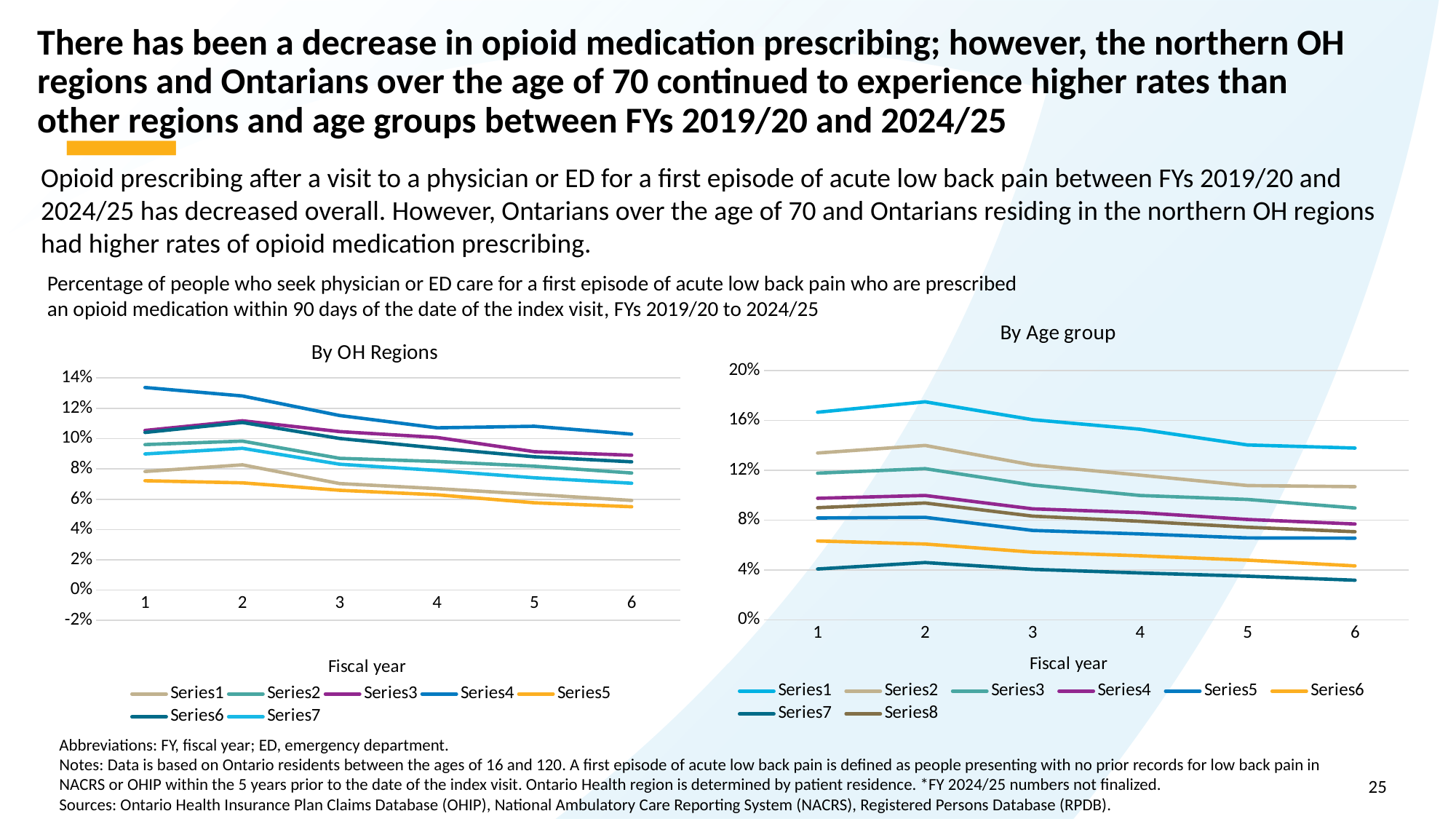
In the 'By Age group' chart, is the value for Series7 at fiscal year 6 greater or less than 4%? less How many series does the legend of the 'By Age group' chart list? 8 In the 'By OH Regions' chart, does Series4 generally rise or fall from fiscal year 1 to fiscal year 6? fall In the 'By OH Regions' chart, is the value for Series4 at fiscal year 1 greater or less than 12%? greater In the 'By Age group' chart, which series has the lowest value at fiscal year 6? Series7 In the 'By OH Regions' chart, which series has the highest value at fiscal year 1? Series4 In the 'By OH Regions' chart, which series has the lowest value at fiscal year 6? Series5 How many series does the legend of the 'By OH Regions' chart list? 7 In the 'By Age group' chart, which is larger at fiscal year 6: Series2 or Series6? Series2 What kind of chart is the 'By OH Regions' chart? line chart How many fiscal year points are plotted along the x axis of the 'By Age group' chart? 6 In the 'By Age group' chart, which series has the highest value at fiscal year 2? Series1